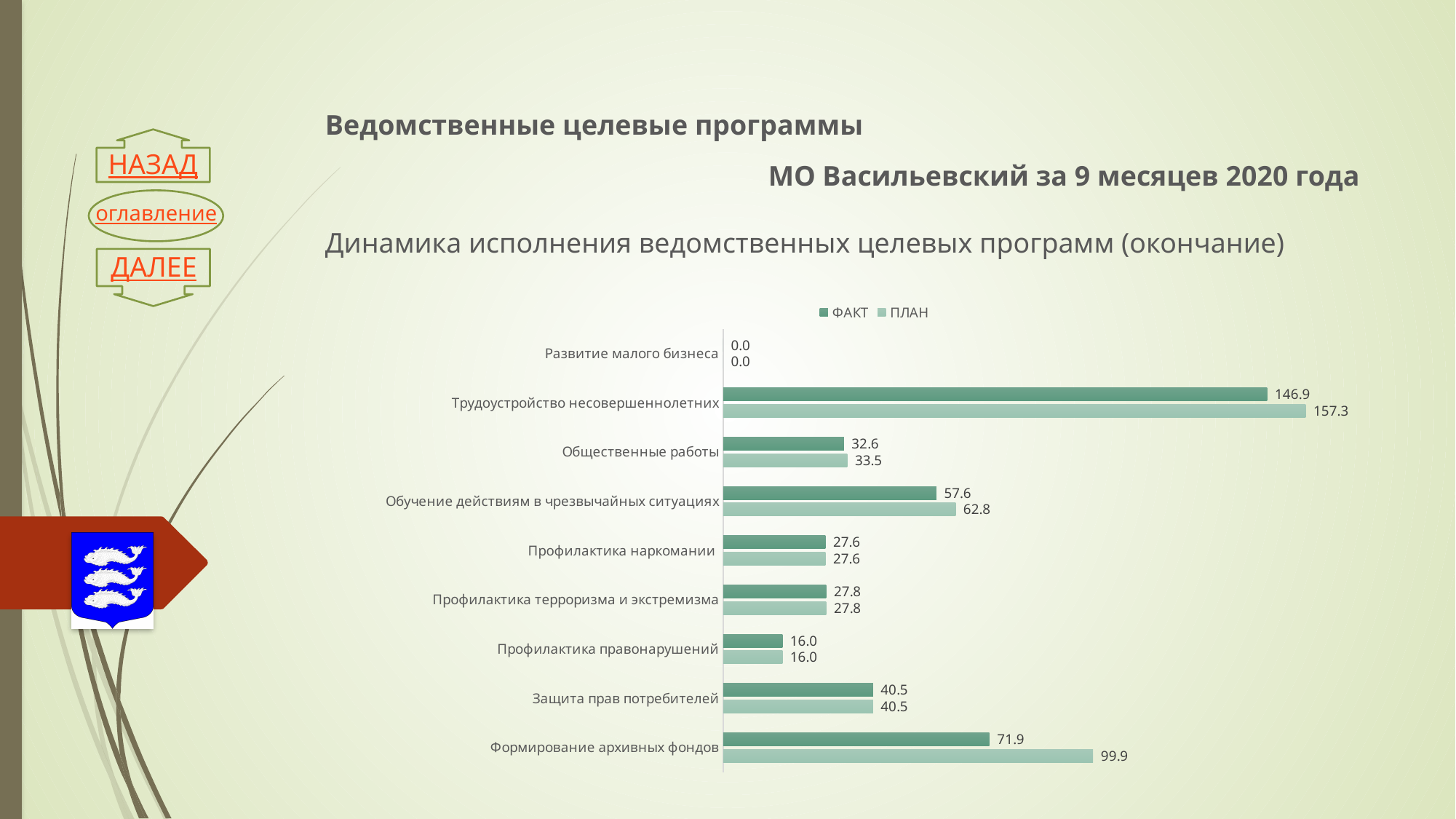
How many series does the legend list? 2 What is the difference between the ПЛАН and ФАКТ values for Трудоустройство несовершеннолетних? 10.4 Which category has the highest ПЛАН value? Трудоустройство несовершеннолетних What kind of chart is shown on the slide? Bar chart What are the two series named in the legend? ФАКТ and ПЛАН Which is larger for Общественные работы, the ФАКТ value or the ПЛАН value? ПЛАН What is the difference between the ПЛАН and ФАКТ values for Формирование архивных фондов? 28.0 What is the ПЛАН value for Формирование архивных фондов? 99.9 What is the ФАКТ value for Трудоустройство несовершеннолетних? 146.9 How many categories are shown on the chart? 9 What is the ПЛАН value for Обучение действиям в чрезвычайных ситуациях? 62.8 Which category has the lowest ФАКТ value? Развитие малого бизнеса